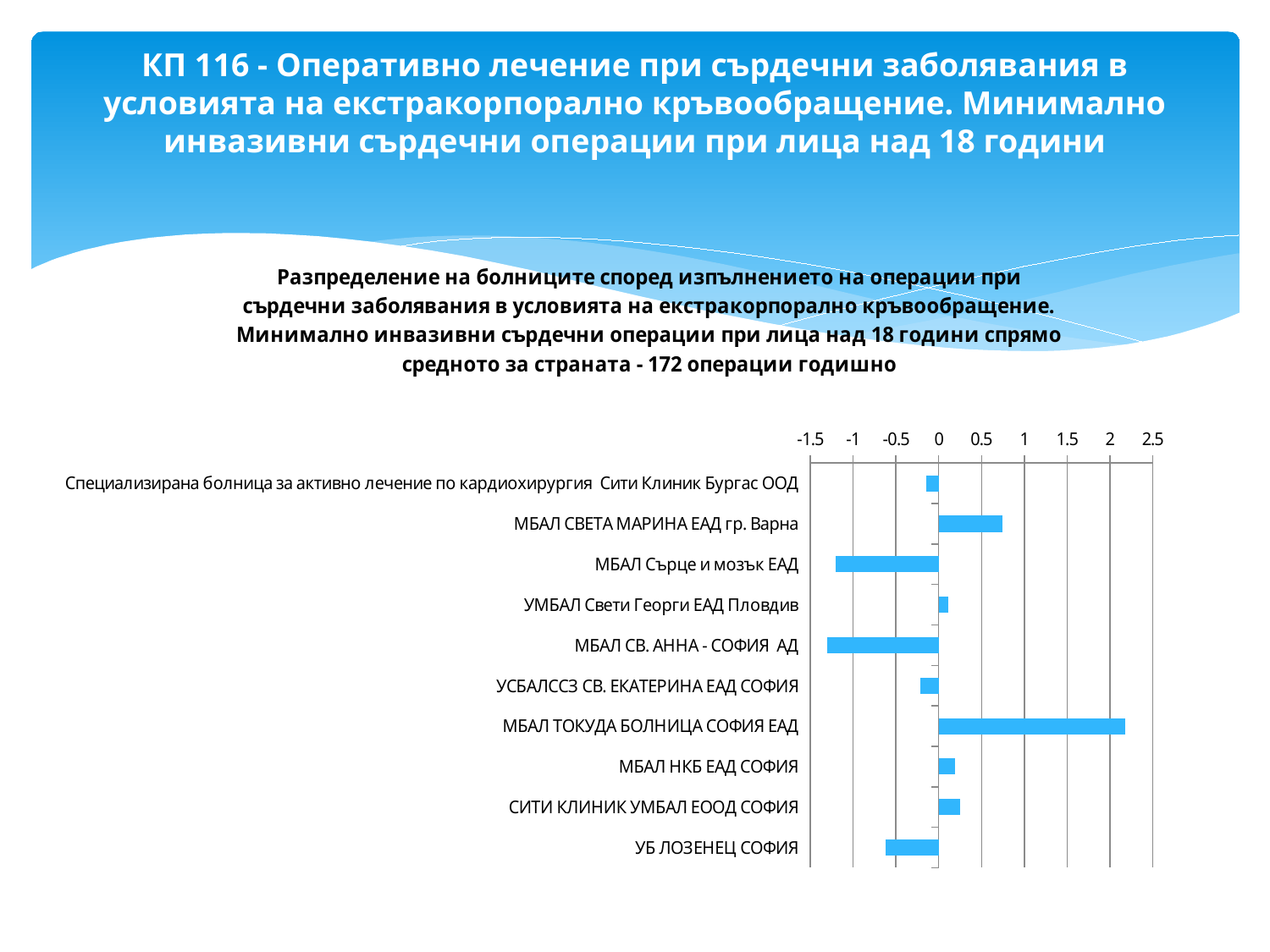
What is the highest value shown on the chart's horizontal axis? 2.5 Is the value for МБАЛ Сърце и мозък ЕАД greater or less than -1? less Which hospital has the highest value on the chart? МБАЛ ТОКУДА БОЛНИЦА СОФИЯ ЕАД Is the value for МБАЛ СВ. АННА - СОФИЯ АД greater or less than -1? less Is the value for УБ ЛОЗЕНЕЦ СОФИЯ greater or less than -0.5? less How many hospitals are listed on the chart? 10 Which has the larger value: МБАЛ ТОКУДА БОЛНИЦА СОФИЯ ЕАД or МБАЛ СВЕТА МАРИНА ЕАД гр. Варна? МБАЛ ТОКУДА БОЛНИЦА СОФИЯ ЕАД According to the chart title, what is the national average number of operations per year? 172 Which has the larger value: МБАЛ СВЕТА МАРИНА ЕАД гр. Варна or МБАЛ НКБ ЕАД СОФИЯ? МБАЛ СВЕТА МАРИНА ЕАД гр. Варна What kind of chart is shown on the slide? bar chart